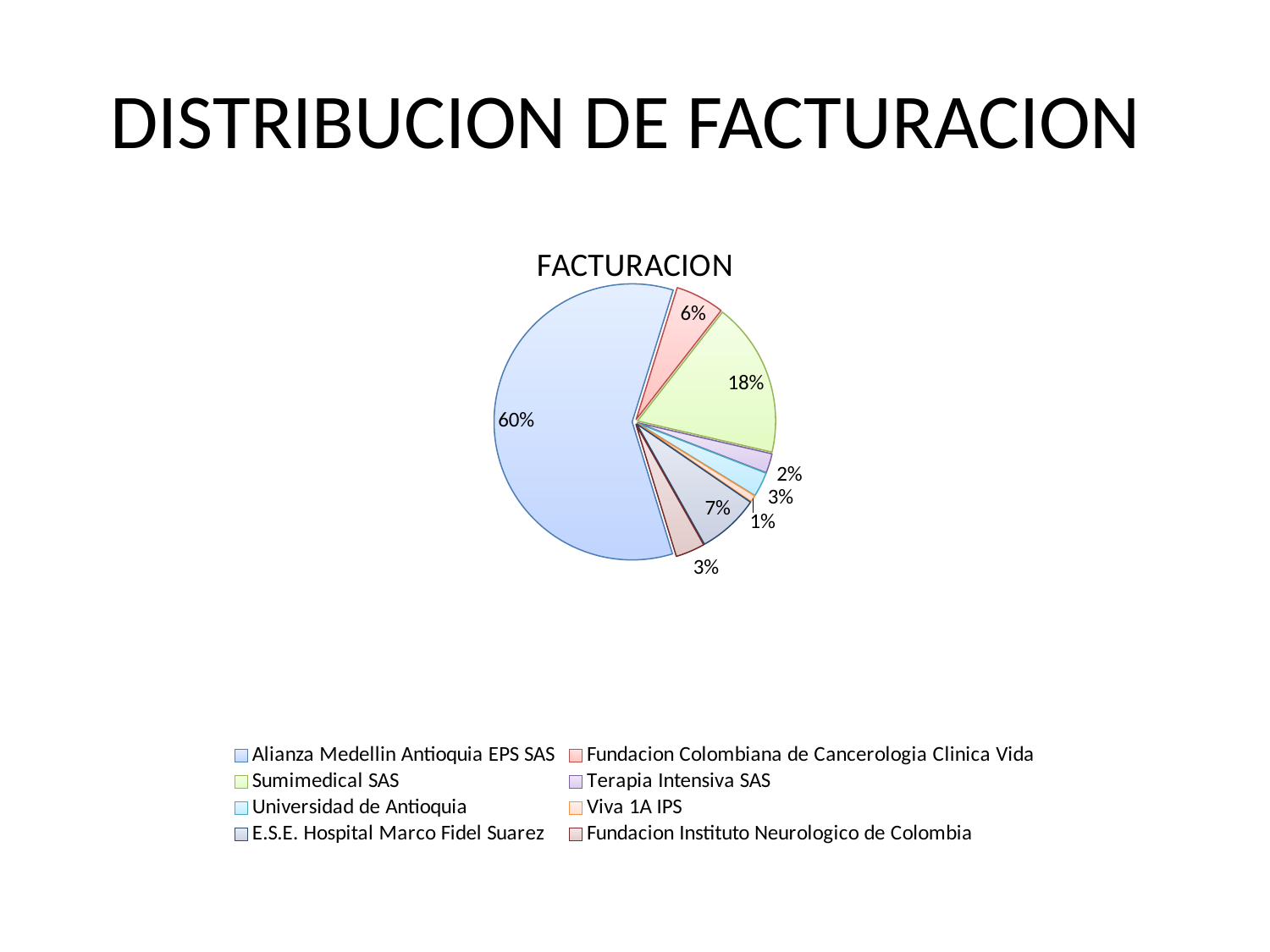
What is the difference in percentage points between Alianza Medellin Antioquia EPS SAS and Sumimedical SAS? 42 Which is larger, the slice for E.S.E. Hospital Marco Fidel Suarez or the slice for Fundacion Colombiana de Cancerologia Clinica Vida? E.S.E. Hospital Marco Fidel Suarez Which category has the largest slice of the pie? Alianza Medellin Antioquia EPS SAS What share of the pie does Sumimedical SAS hold? 18% What share of the pie does Fundacion Colombiana de Cancerologia Clinica Vida hold? 6% What kind of chart is shown on the slide? Pie chart Which category has the smallest slice of the pie? Viva 1A IPS What share of the pie does Alianza Medellin Antioquia EPS SAS hold? 60% How many categories does the legend list? 8 What is the title of the chart? FACTURACION